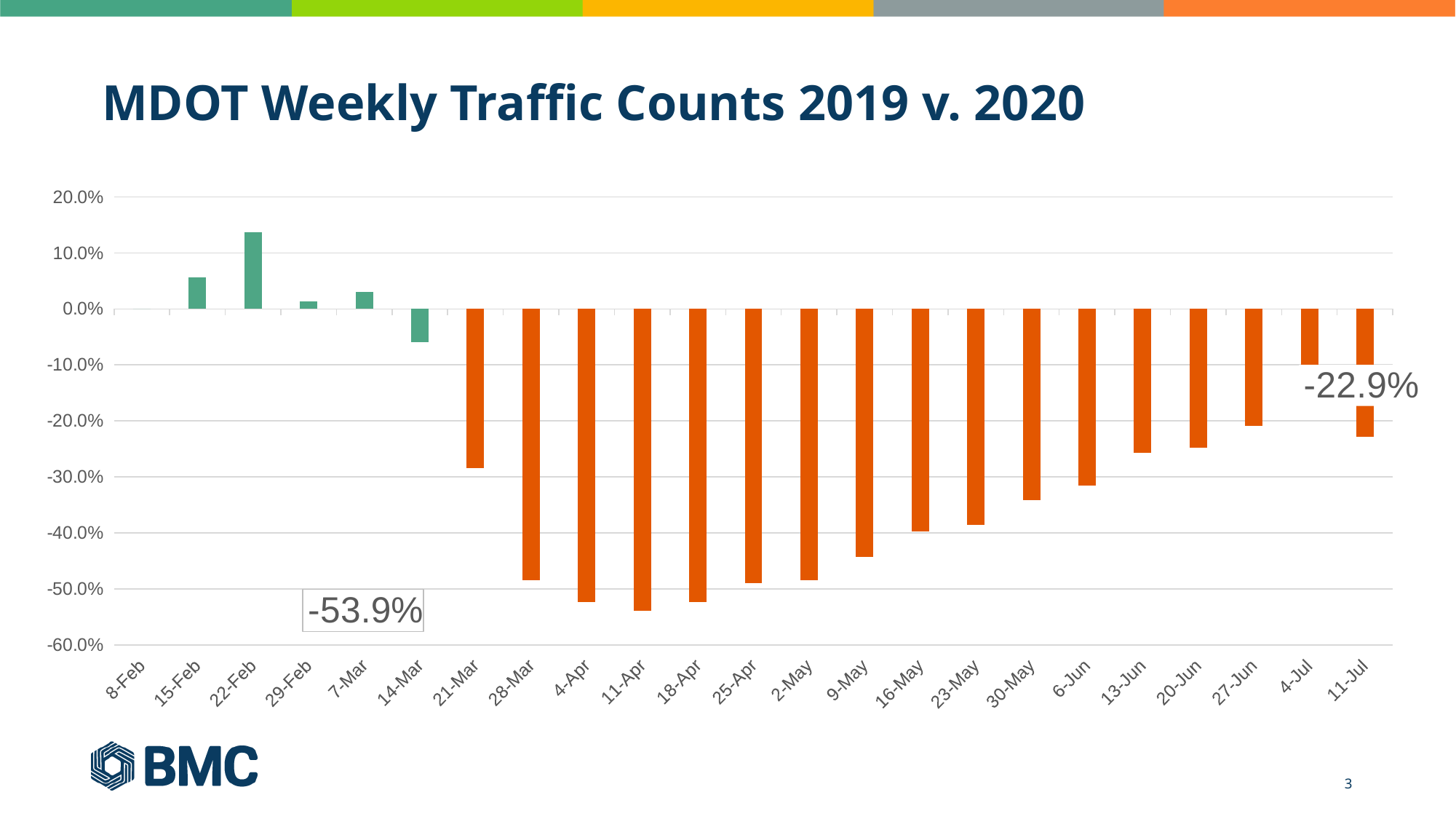
Do the values rise or fall from 11-Apr to 11-Jul? rise Which week has the highest value? 22-Feb Is the value for 28-Mar greater or less than -40.0%? less Is the value for 9-May greater or less than -40.0%? less What is the title of the chart? MDOT Weekly Traffic Counts 2019 v. 2020 What is the lowest value labelled on the chart? -53.9% Which is larger, the value for 15-Feb or the value for 22-Feb? 22-Feb Is the value for 21-Mar greater or less than -30.0%? greater What is the value labelled for 11-Jul? -22.9% How many weekly categories are shown on the x axis? 23 What kind of chart is shown on the slide? bar chart Which week has the lowest value? 11-Apr